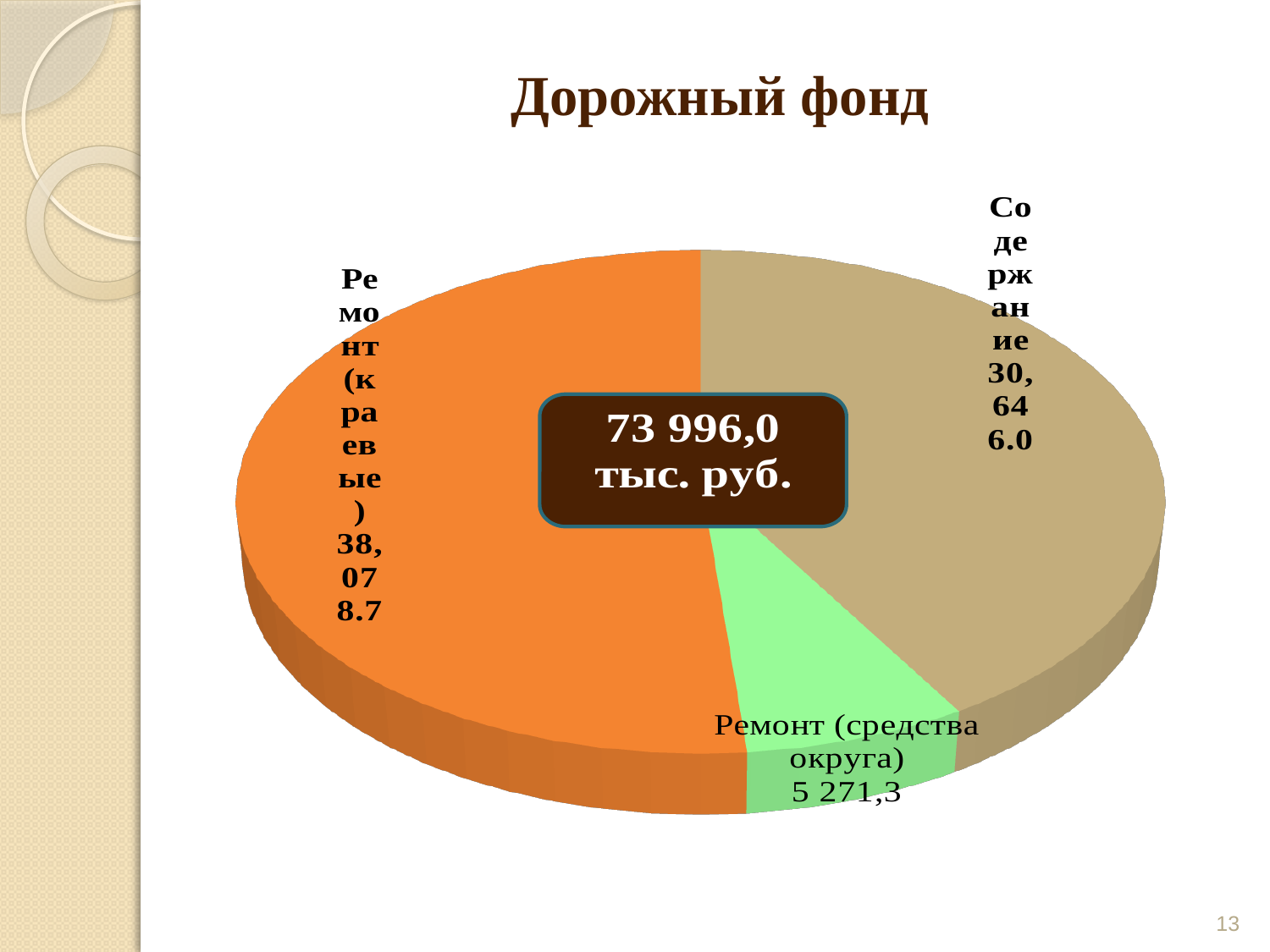
How many slices does the pie chart have? 3 What is the title of the chart? Дорожный фонд What total amount is shown in the centre of the pie chart? 73 996,0 тыс. руб. Which slice of the pie is the largest? Ремонт (краевые) Which is larger, Содержание or Ремонт (средства округа)? Содержание What is the value for Содержание? 30,646.0 What is the value for Ремонт (краевые)? 38,078.7 What share of the total 73 996,0 does Ремонт (средства округа) represent? 7.1% What is the value for Ремонт (средства округа)? 5 271,3 What is the difference between the values for Ремонт (краевые) and Содержание? 7,432.7 Which slice of the pie is the smallest? Ремонт (средства округа) What kind of chart is shown on the slide? pie chart